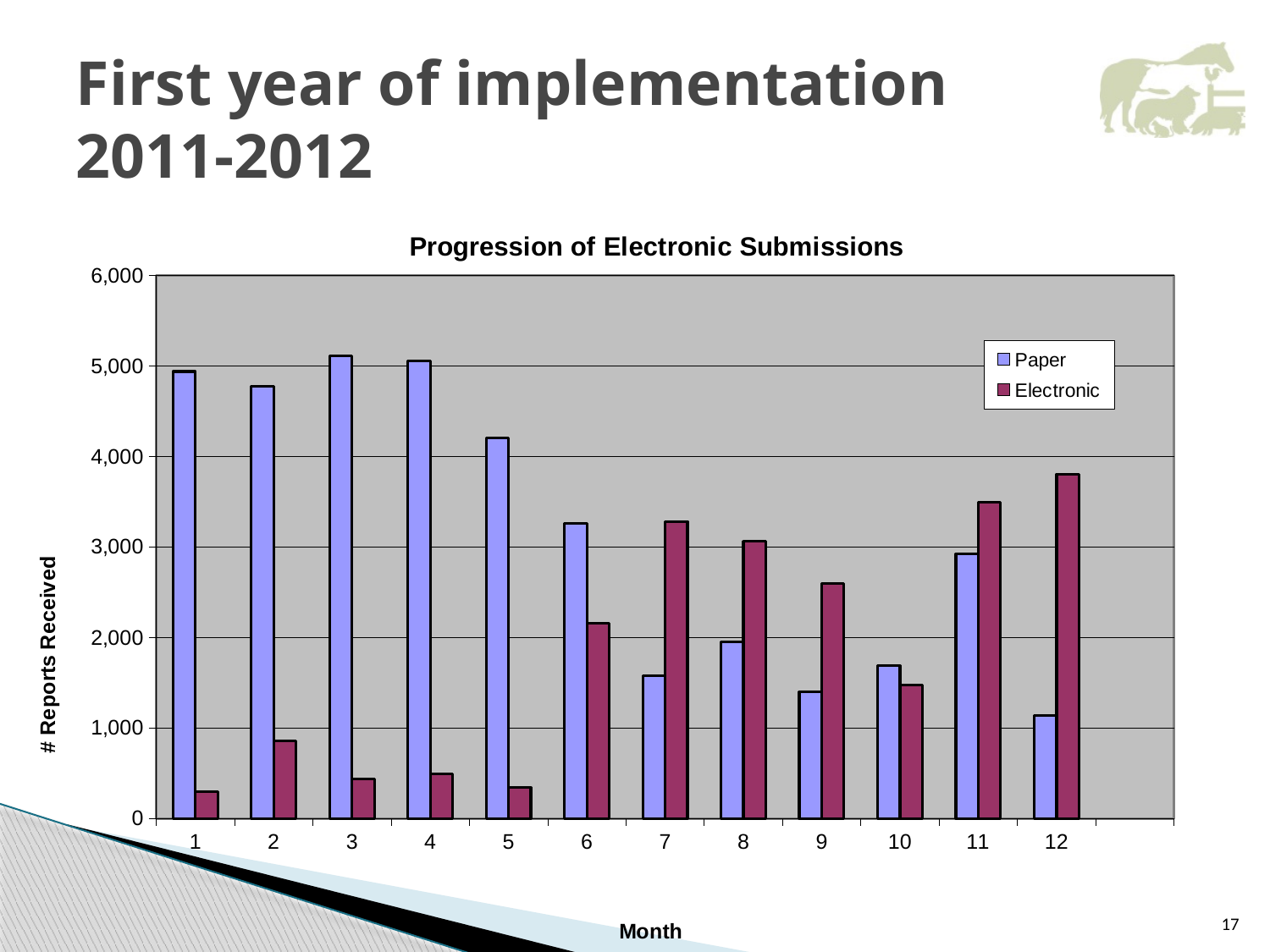
Is the Electronic value for month 2 greater or less than 1,000? less In which month is the Electronic value highest? 12 What is the title of the chart? Progression of Electronic Submissions Is the Paper value for month 1 greater or less than 4,000? greater How many series does the legend list? 2 How many months are shown on the x axis? 12 In month 1, which is larger, Paper or Electronic? Paper Do the Paper values generally rise or fall from month 1 to month 12? fall What kind of chart is shown on the slide? bar chart In which month is the Paper value lowest? 12 In month 7, which is larger, Paper or Electronic? Electronic Is the Electronic value for month 12 greater or less than 3,000? greater